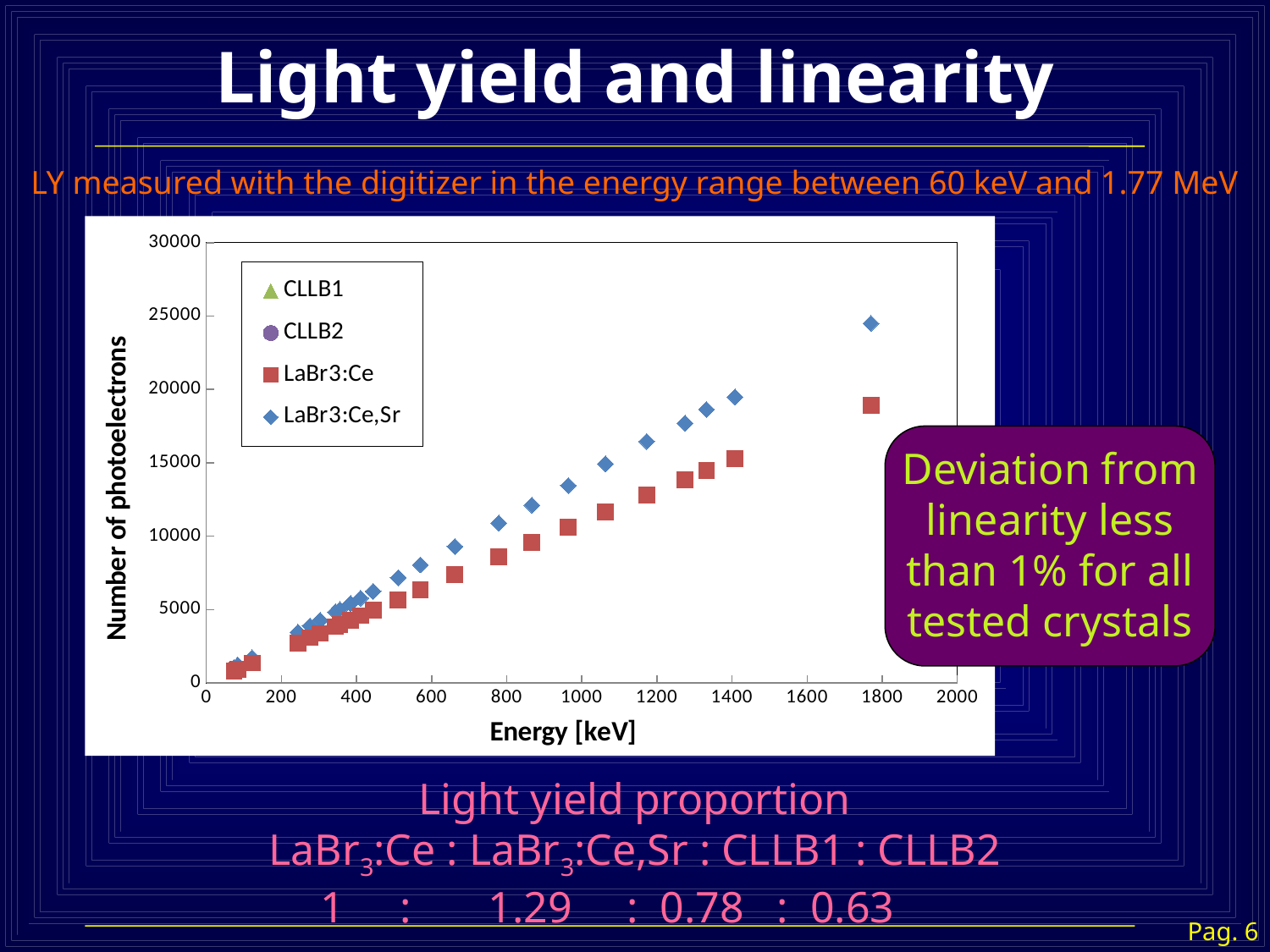
How many series does the chart legend list? 4 Do the number of photoelectrons rise or fall as energy increases along the x axis? rise What is the title of the x axis of the chart? Energy [keV] Is the highest-energy LaBr3:Ce,Sr point greater or less than 20000 photoelectrons? greater What kind of chart is shown on the slide? scatter chart At the highest plotted energy (around 1800 keV), which series has more photoelectrons, LaBr3:Ce or LaBr3:Ce,Sr? LaBr3:Ce,Sr Is the LaBr3:Ce,Sr point near 1400 keV greater or less than 20000 photoelectrons? less What is the title of the y axis of the chart? Number of photoelectrons Is the LaBr3:Ce point near 1200 keV greater or less than 10000 photoelectrons? greater Which series reaches the highest number of photoelectrons on the chart? LaBr3:Ce,Sr What is the maximum value shown on the y axis of the chart? 30000